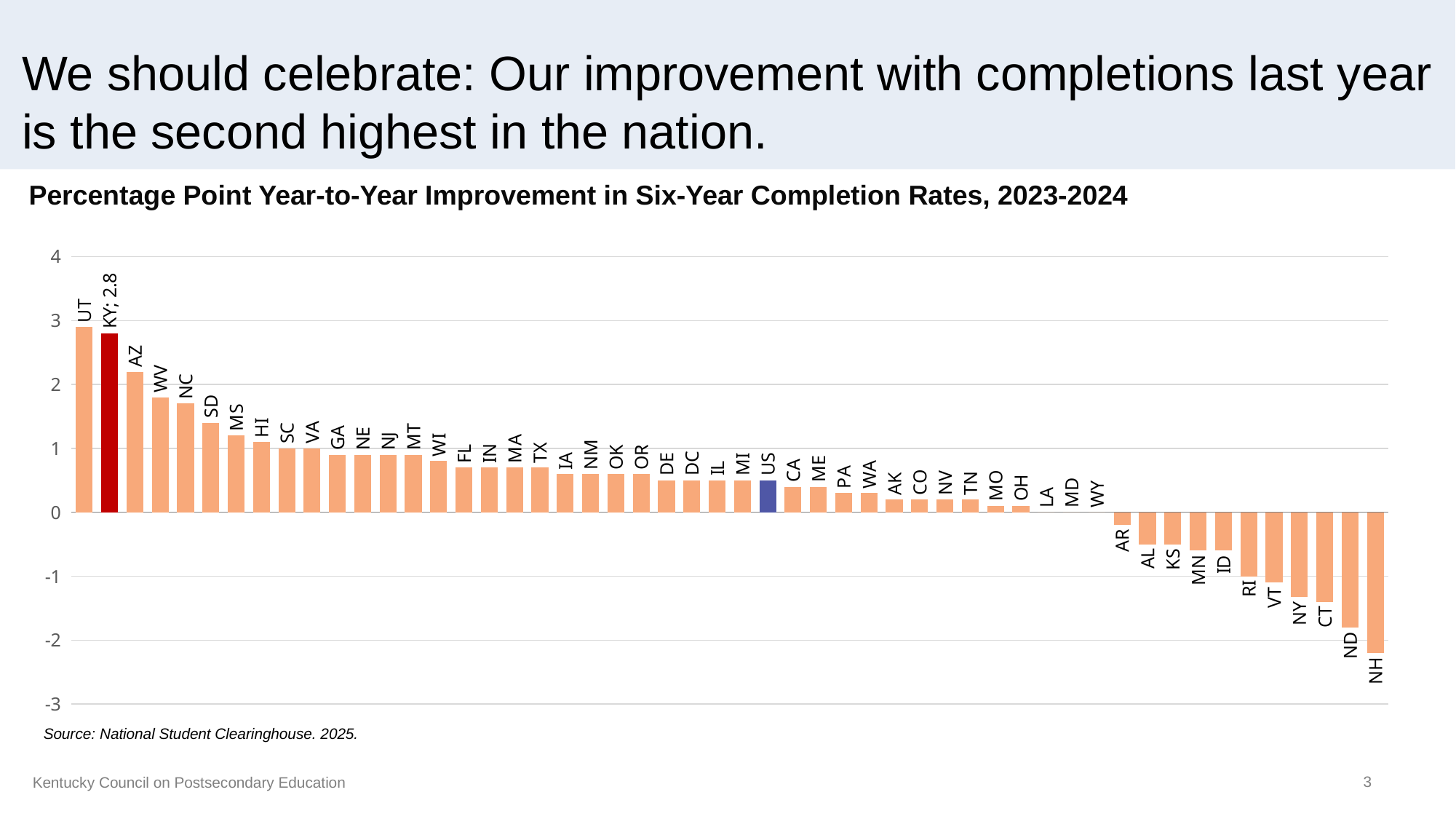
Which bar is highlighted in red? KY Is the value for WV greater or less than 2? less What kind of chart is shown on the slide? bar chart Is the value for NH greater or less than -2? less Which has the larger value, AZ or WV? AZ Is the value for UT greater or less than 2? greater Which has the lower value, ND or NH? NH How many bars on the chart have negative values? 11 Which state has the lowest value on the chart? NH Do the values rise or fall moving from left to right along the x axis? fall What is the value shown for KY? 2.8 Which state has the highest percentage point improvement? UT